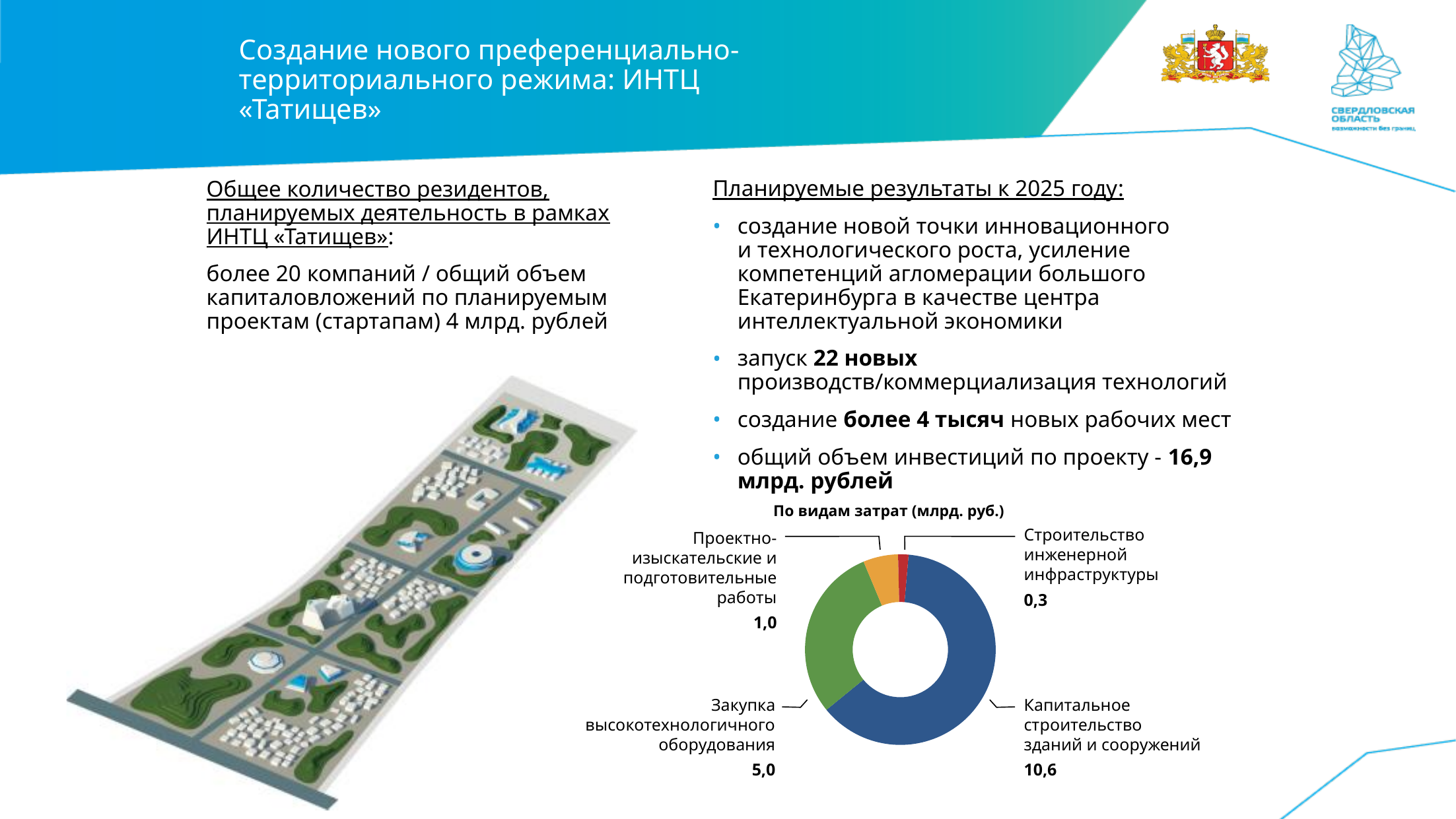
In the chart «По видам затрат (млрд. руб.)», what is the value for «Строительство инженерной инфраструктуры»? 0,3 Which category has the smallest slice in the chart «По видам затрат (млрд. руб.)»? Строительство инженерной инфраструктуры How many categories are shown in the chart «По видам затрат (млрд. руб.)»? 4 In the chart «По видам затрат (млрд. руб.)», what is the value for «Капитальное строительство зданий и сооружений»? 10,6 Which category has the largest slice in the chart «По видам затрат (млрд. руб.)»? Капитальное строительство зданий и сооружений In the chart «По видам затрат (млрд. руб.)», what is the difference between «Капитальное строительство зданий и сооружений» and «Закупка высокотехнологичного оборудования»? 5,6 What colour is the slice for «Закупка высокотехнологичного оборудования» in the chart «По видам затрат (млрд. руб.)»? Green In the chart «По видам затрат (млрд. руб.)», what is the value for «Закупка высокотехнологичного оборудования»? 5,0 What is the total of all slices in the chart «По видам затрат (млрд. руб.)»? 16,9 In the chart «По видам затрат (млрд. руб.)», what is the value for «Проектно-изыскательские и подготовительные работы»? 1,0 In the chart «По видам затрат (млрд. руб.)», which is larger: «Закупка высокотехнологичного оборудования» or «Проектно-изыскательские и подготовительные работы»? Закупка высокотехнологичного оборудования What kind of chart is shown under the heading «По видам затрат (млрд. руб.)»? Pie chart (donut)